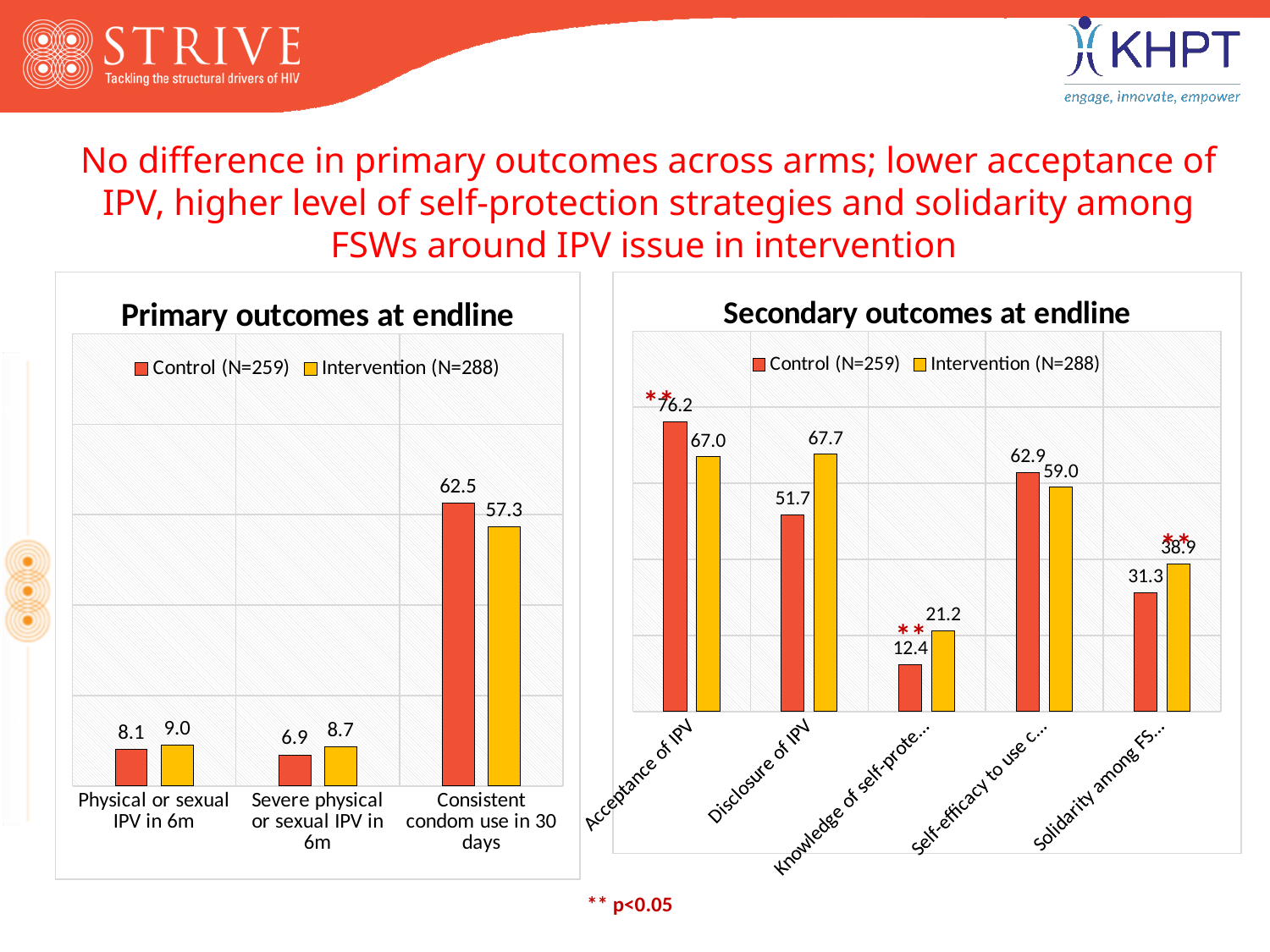
In the 'Primary outcomes at endline' chart, what is the Control value for Consistent condom use in 30 days? 62.5 In the 'Primary outcomes at endline' chart, what is the difference between the Control and Intervention values for Consistent condom use in 30 days? 5.2 What type of chart is 'Primary outcomes at endline'? Bar chart In the 'Secondary outcomes at endline' chart, which is larger for Disclosure of IPV, the Control value or the Intervention value? Intervention In the 'Primary outcomes at endline' chart, which category has the lowest Control value? Severe physical or sexual IPV in 6m In the 'Primary outcomes at endline' chart, how many categories are shown on the x axis? 3 In the 'Secondary outcomes at endline' chart, what is the Intervention value for Disclosure of IPV? 67.7 In the 'Secondary outcomes at endline' chart, what is the Control value for Acceptance of IPV? 76.2 How many series does the legend of the 'Secondary outcomes at endline' chart list? 2 In the 'Primary outcomes at endline' chart, what is the Intervention value for Severe physical or sexual IPV in 6m? 8.7 In the 'Secondary outcomes at endline' chart, what is the difference between the Control and Intervention values for Acceptance of IPV? 9.2 In the 'Secondary outcomes at endline' chart, which category has the highest Control value? Acceptance of IPV